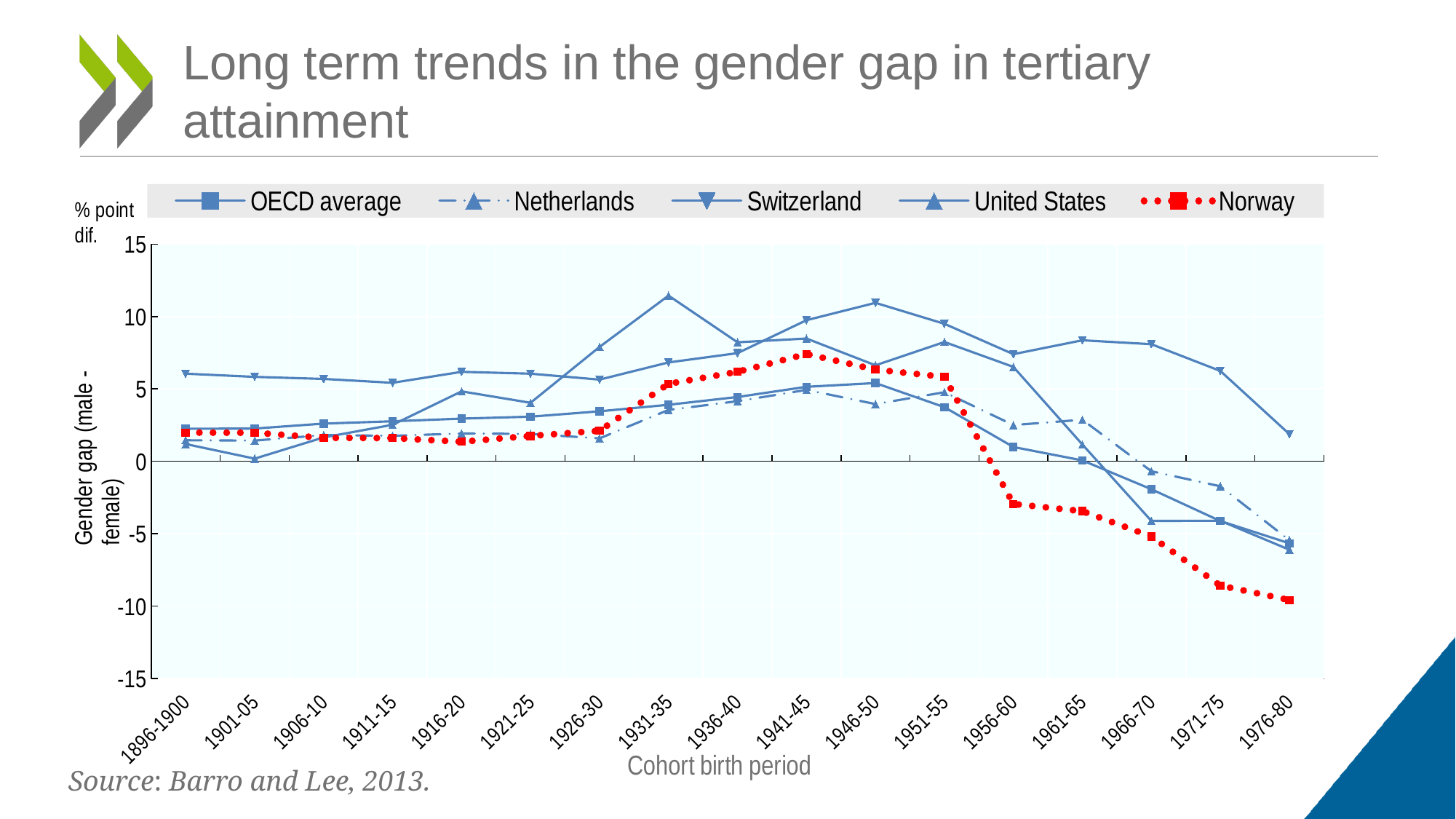
What type of chart is shown on the slide? line chart Which series has the highest value in the 1966-70 cohort? Switzerland Do the values for Norway rise or fall from the 1951-55 cohort to the 1976-80 cohort? fall Which series is drawn as a red dotted line? Norway Is the value for Norway in the 1976-80 cohort greater or less than -5? less How many cohort birth periods are shown on the x axis? 17 Is the value for the OECD average in the 1896-1900 cohort greater or less than 5? less How many series does the legend list? 5 Which series has the lowest value in the 1976-80 cohort? Norway Is the value for Switzerland in the 1946-50 cohort greater or less than 10? greater Which series has the highest value in the 1896-1900 cohort? Switzerland In the 1976-80 cohort, which is larger: the value for Switzerland or the value for Norway? Switzerland